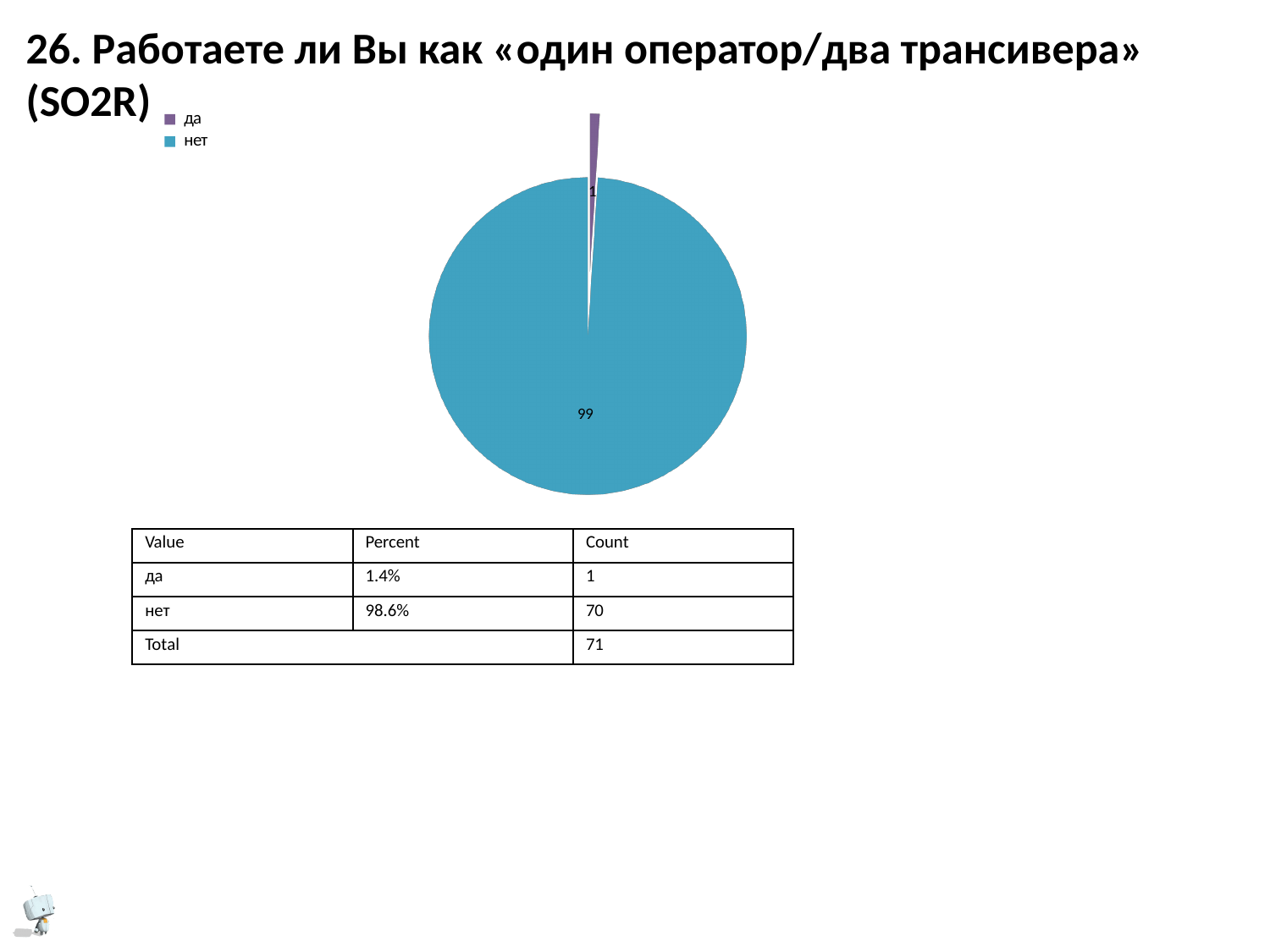
What data label is shown on the "да" slice of the pie chart? 1 What data label is shown on the "нет" slice of the pie chart? 99 What kind of chart is shown on the slide? pie chart Which slice of the pie chart is the largest? нет How many slices does the pie chart have? 2 According to the table below the pie chart, what is the total count of respondents? 71 According to the table below the pie chart, what percent of respondents answered "нет"? 98.6% According to the table below the pie chart, what is the count for "да"? 1 Which is larger in the pie chart, the "да" slice or the "нет" slice? нет Which slice of the pie chart is the smallest? да What colour is the "нет" slice in the pie chart? blue How many entries does the legend of the pie chart list? 2